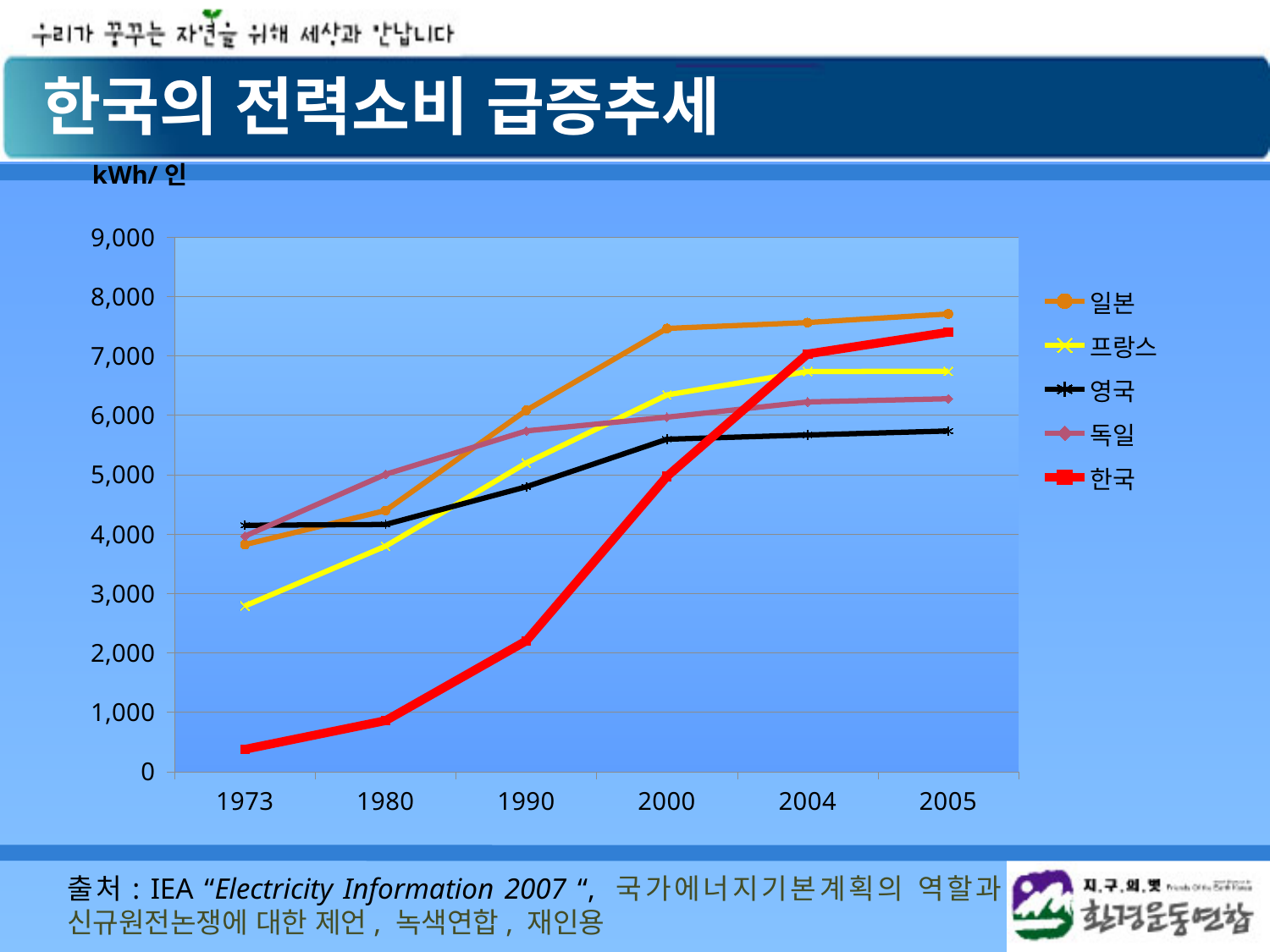
What unit label is shown above the y axis? kWh/인 Is the value for 한국 in 1973 greater or less than 1,000? less Which series has the highest value in 1980? 독일 Which series has the lowest value in 1973? 한국 Is the value for 영국 in 2005 greater or less than 6,000? less How many series does the legend list? 5 What kind of chart is shown on the slide? line chart Does the value for 한국 rise or fall from 1973 to 2005? rise How many years are shown on the x axis? 6 Is the value for 일본 in 2000 greater or less than 7,000? greater In 1990, which is larger, the value for 일본 or the value for 한국? 일본 Which series has the lowest value in 1990? 한국